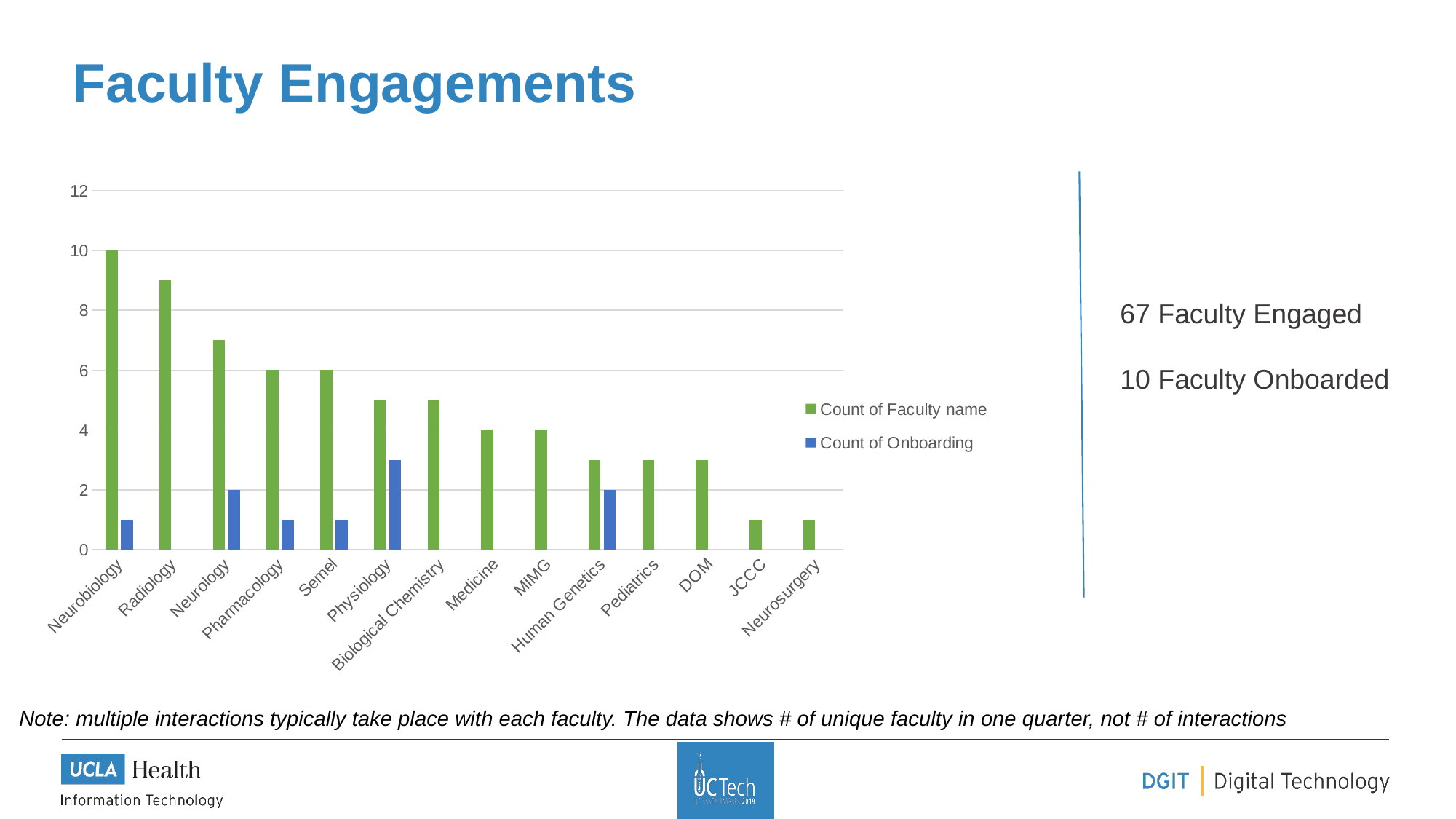
What is the Count of Faculty name for Medicine? 4 What is the Count of Faculty name for Neurobiology? 10 Which department has the highest Count of Faculty name? Neurobiology What kind of chart is shown on the slide? bar chart How many series does the legend list? 2 Is the Count of Faculty name for Radiology greater or less than 8? greater Which is larger, the Count of Faculty name for Neurology or for Physiology? Neurology Do the Count of Faculty name values rise or fall from left to right along the x axis? fall Is the Count of Faculty name for Pediatrics greater or less than 4? less Which department has the highest Count of Onboarding? Physiology What is the Count of Onboarding for Neurology? 2 How many departments are shown on the x axis? 14